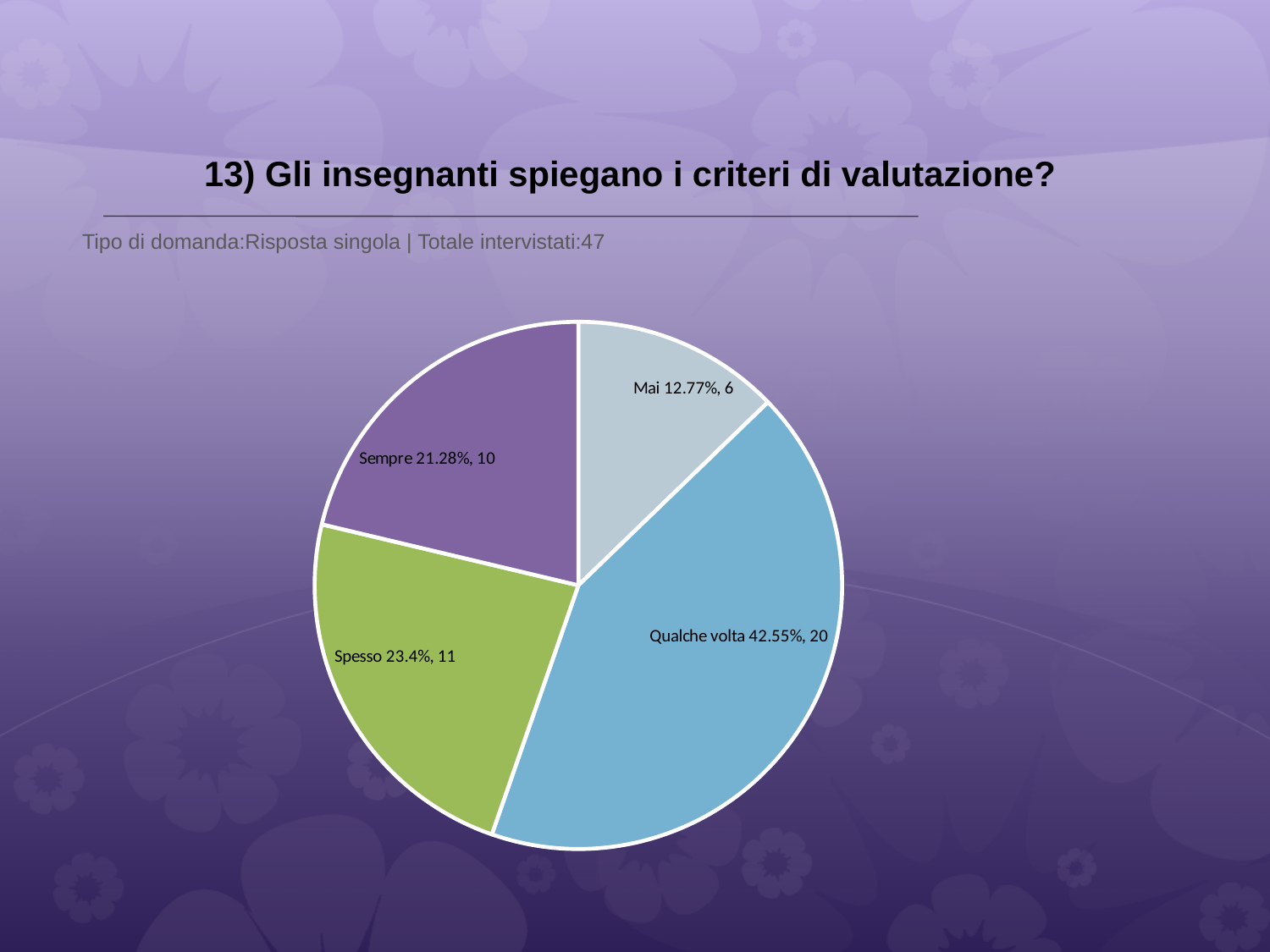
What kind of chart is shown on the slide? pie chart Which category has the smallest slice? Mai What is the difference in respondent count between "Qualche volta" and "Spesso"? 9 What percentage share does the "Qualche volta" slice have? 42.55% Which category has the largest slice? Qualche volta What is the title of the chart on the slide? 13) Gli insegnanti spiegano i criteri di valutazione? What is the total number of respondents across all slices? 47 How many respondents answered "Sempre"? 10 Which has more respondents, "Spesso" or "Sempre"? Spesso How many slices does the pie chart have? 4 How many respondents answered "Mai"? 6 What percentage share does the "Spesso" slice have? 23.4%